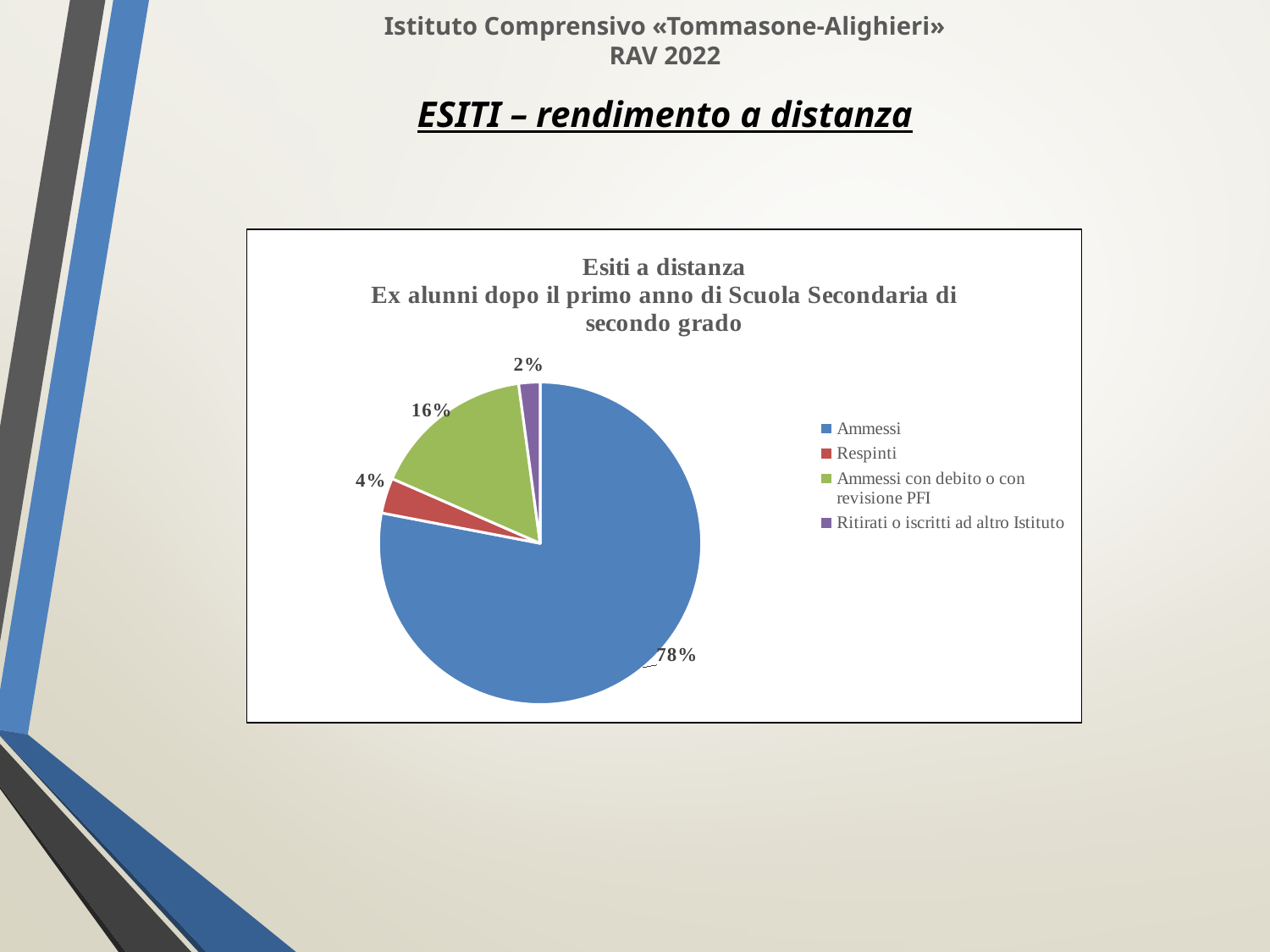
What share of the pie does the Ammessi slice represent? 78% Which is larger, the Respinti slice or the 'Ritirati o iscritti ad altro Istituto' slice? Respinti What is the difference in percentage points between the Ammessi slice and the 'Ammessi con debito o con revisione PFI' slice? 62 What share of the pie does the 'Ammessi con debito o con revisione PFI' slice represent? 16% What colour is the Respinti slice? Red What kind of chart is shown on the slide? Pie chart What share of the pie does the Respinti slice represent? 4% How many entries does the legend list? 4 Which category has the smallest slice of the pie? Ritirati o iscritti ad altro Istituto Which category has the largest slice of the pie? Ammessi How many slices does the pie chart have? 4